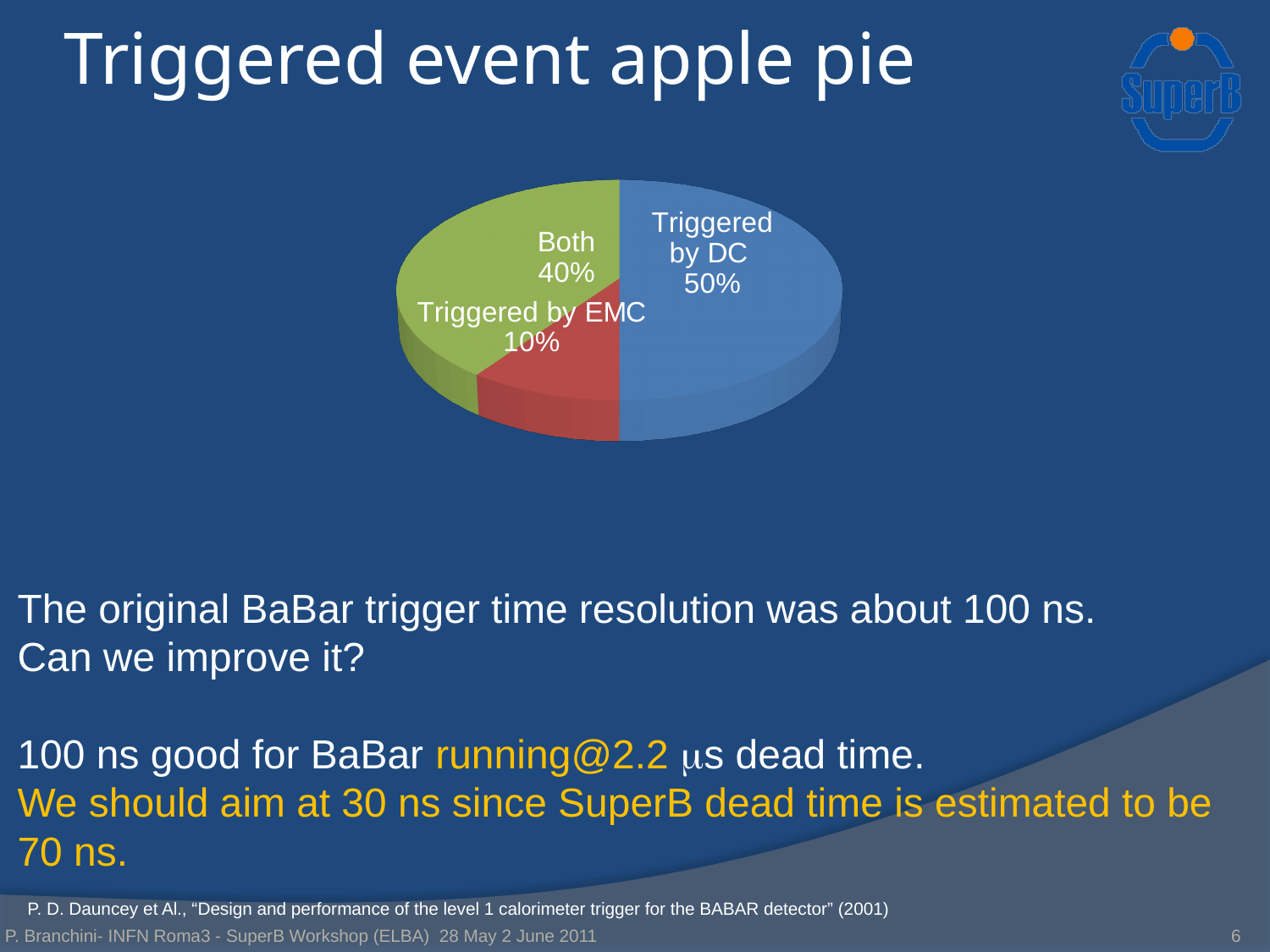
Which is larger, the 'Both' slice or the 'Triggered by EMC' slice? Both Which slice of the pie is the smallest? Triggered by EMC What colour is the 'Triggered by DC' slice? blue What share of triggered events is triggered by EMC? 10% What is the title of the slide containing the pie chart? Triggered event apple pie What is the difference in percentage points between the 'Both' slice and the 'Triggered by EMC' slice? 30 What share of triggered events is triggered by DC? 50% Which slice of the pie is the largest? Triggered by DC What is the difference in percentage points between the 'Triggered by DC' slice and the 'Both' slice? 10 What kind of chart is shown on the slide? pie chart How many slices does the pie chart have? 3 What share of triggered events is triggered by both? 40%